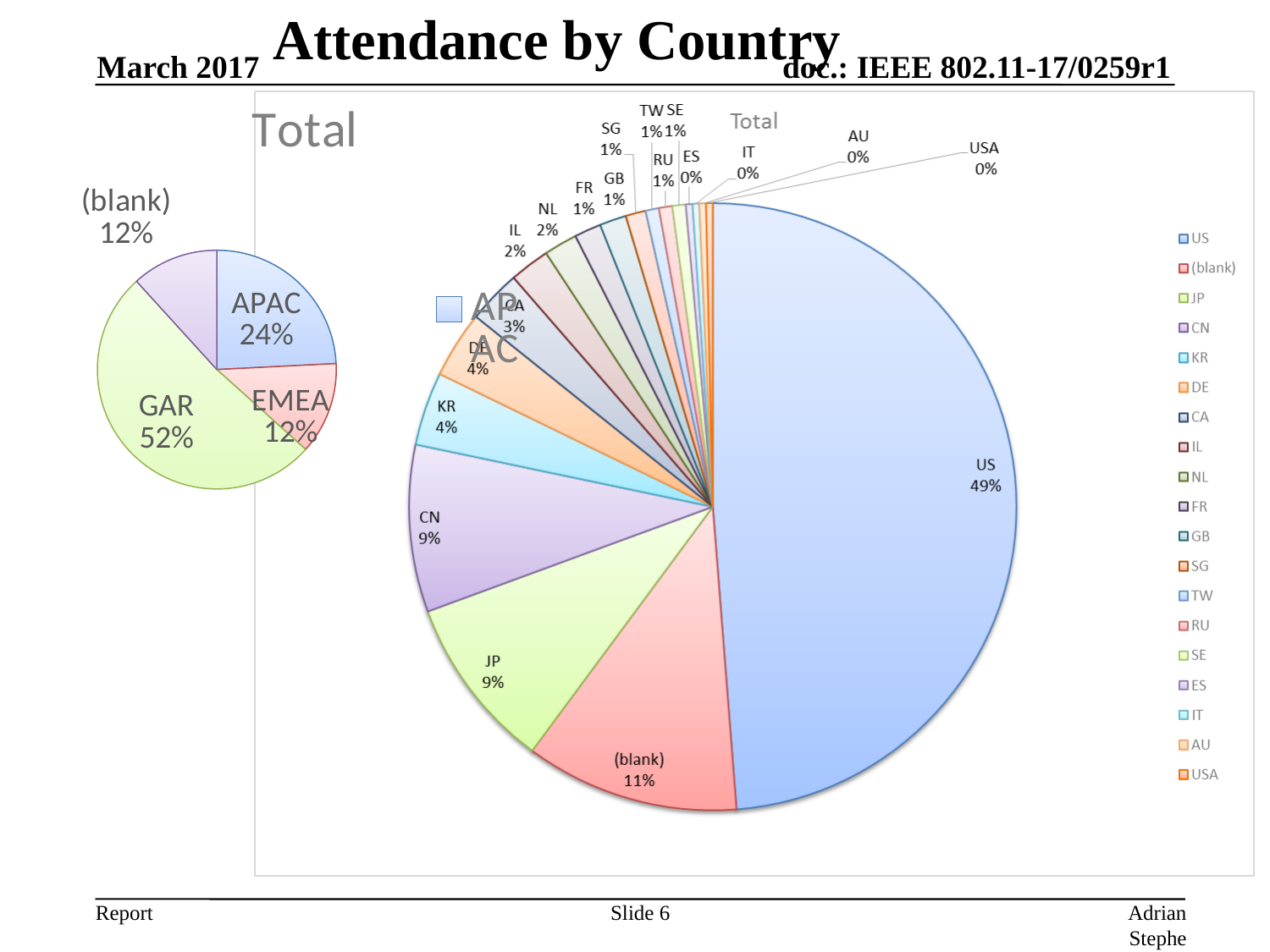
In the small pie chart on the left, how many slices are there? 4 In the small pie chart on the left, what share does GAR have? 52% In the small pie chart on the left, what share does APAC have? 24% In the large pie chart on the right, what share does KR have? 4% In the large pie chart on the right, what share does (blank) have? 11% What kind of chart is the large chart on the right? Pie chart In the large pie chart on the right, which country has the largest slice? US In the large pie chart on the right, how many entries does the legend list? 19 In the large pie chart on the right, what share does US have? 49% In the large pie chart on the right, which is larger, the share for CN or the share for DE? CN In the small pie chart on the left, which region has the largest slice? GAR In the large pie chart on the right, what is the difference between the US share and the JP share? 40%